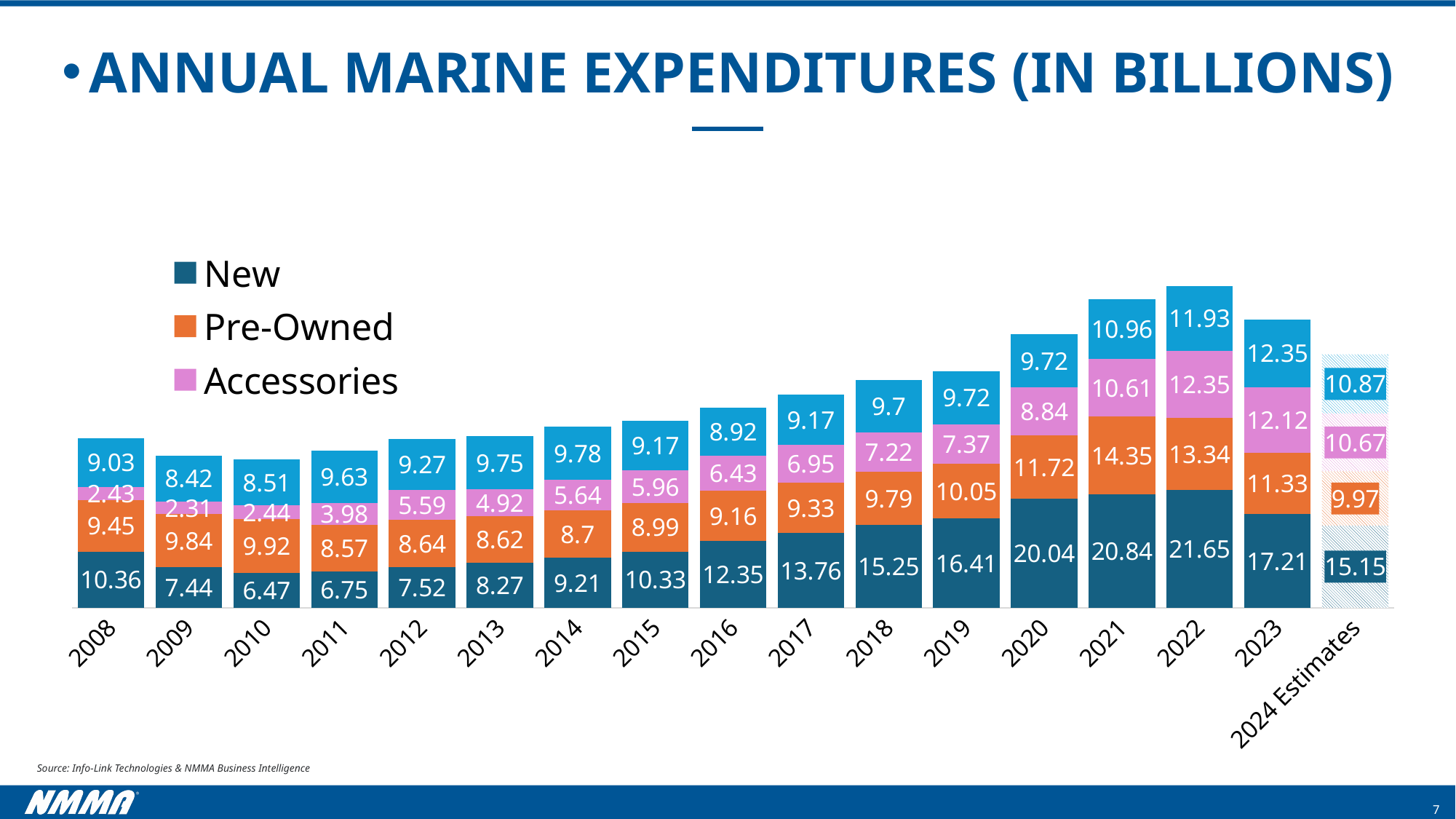
In which year is the Pre-Owned value highest? 2021 Does the New value rise or fall from 2010 to 2022? Rise What type of chart is shown on the slide? Stacked bar chart In which year is the New value lowest? 2010 Which is larger, the Pre-Owned value in 2008 or in 2009? 2009 What is the value for Pre-Owned in 2016? 9.16 What is the value for New in 2008? 10.36 How many series does the legend list? 3 What is the difference between the New value in 2022 and the New value in 2023? 4.44 In which year is the New value highest? 2022 What is the value for Accessories in 2019? 7.37 How many bars (years) are shown on the x axis? 17